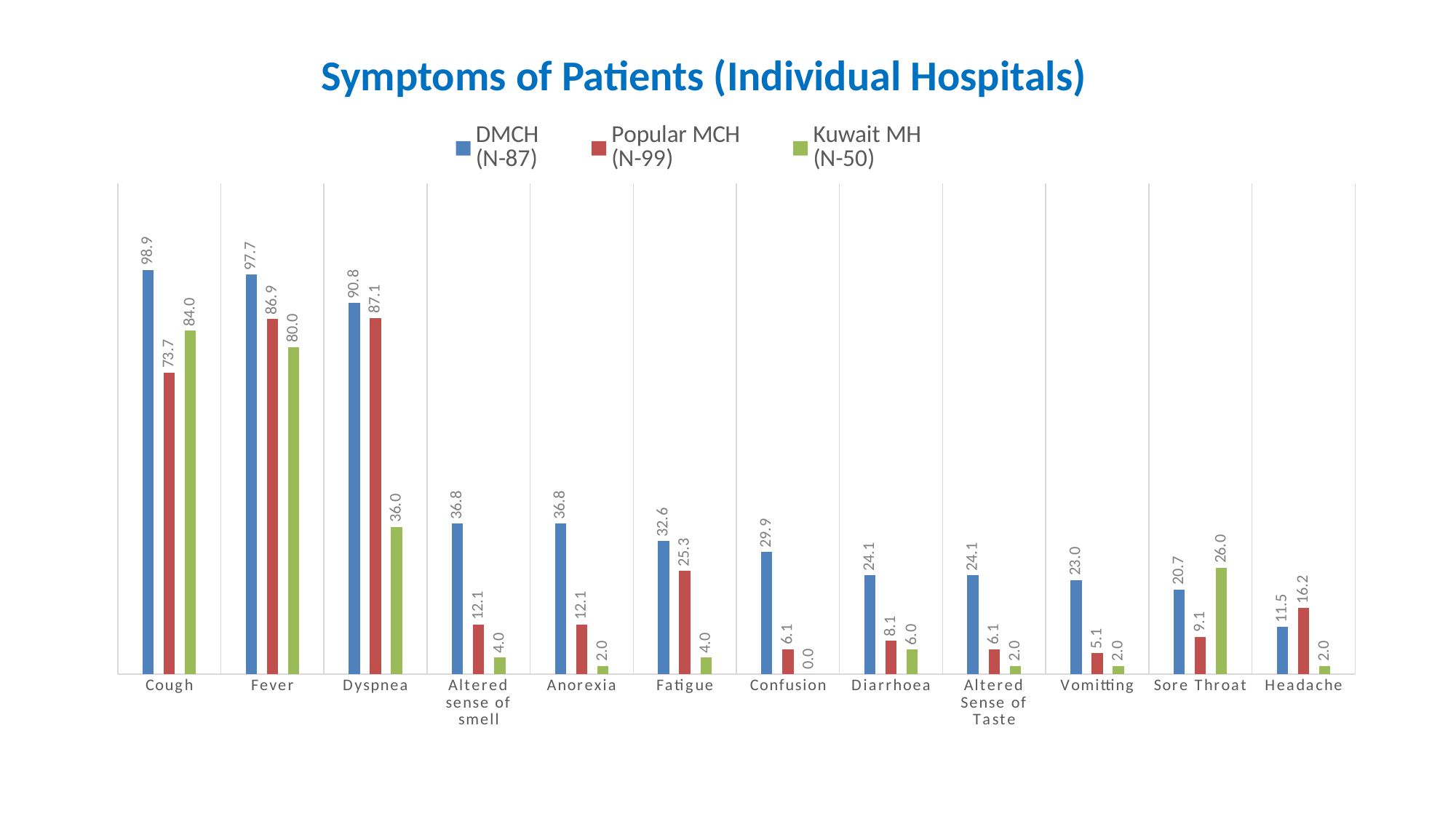
What is the value for Popular MCH (N-99) for Headache? 16.2 Which symptom has the highest value for Kuwait MH (N-50)? Cough What is the value for DMCH (N-87) for Cough? 98.9 What kind of chart is shown on the slide? Bar chart How many symptom categories are shown on the x axis? 12 Which is larger for Sore Throat: the DMCH (N-87) value or the Kuwait MH (N-50) value? Kuwait MH (N-50) What is the value for Kuwait MH (N-50) for Dyspnea? 36.0 What is the difference between the DMCH (N-87) and Popular MCH (N-99) values for Cough? 25.2 Which colour represents Popular MCH (N-99) in the chart? Red What is the title of the chart? Symptoms of Patients (Individual Hospitals) How many series does the legend list? 3 Which symptom has the lowest value for Popular MCH (N-99)? Vomitting